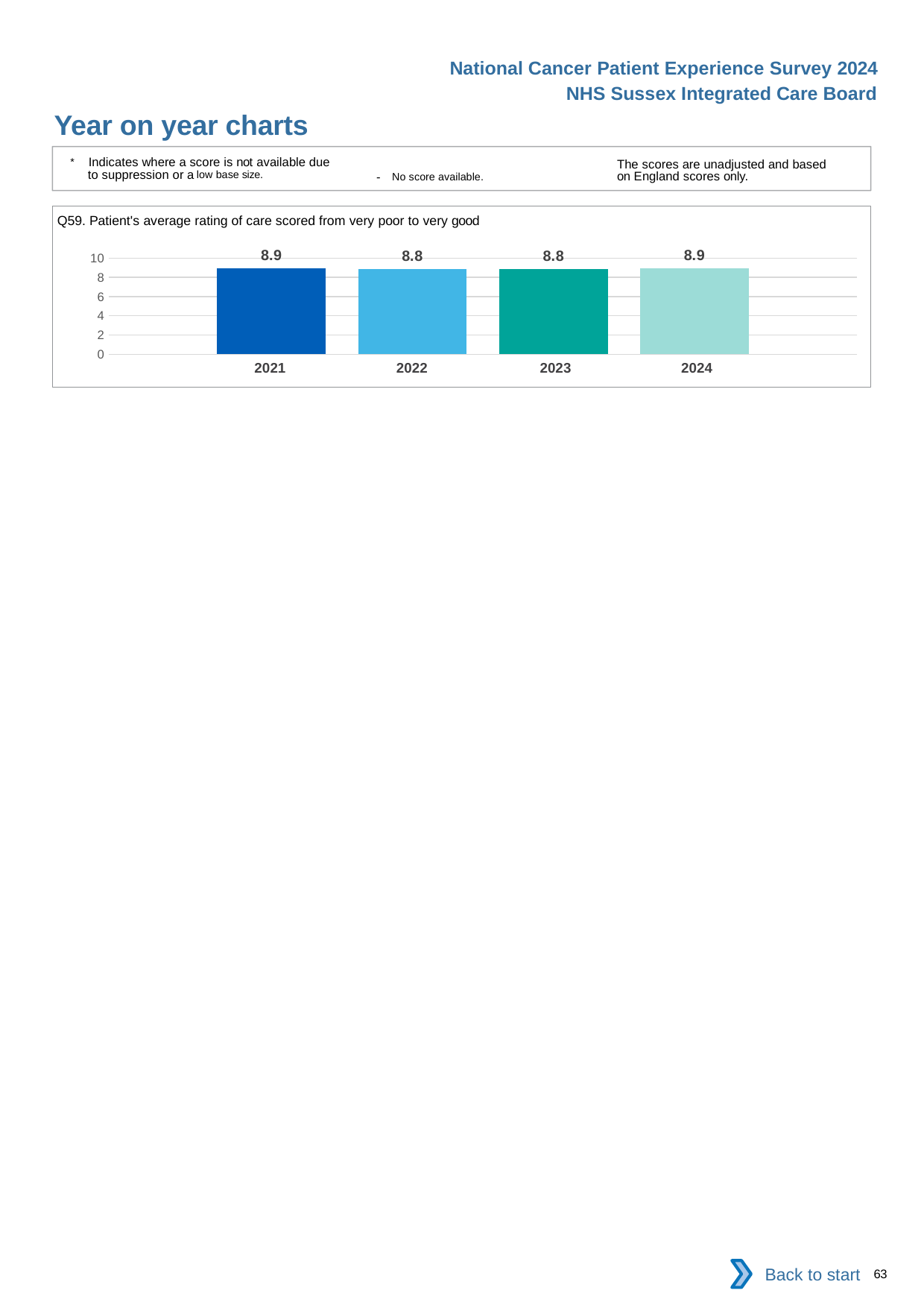
What is the value for 2021? 8.9 What is the value for 2023? 8.8 What is the highest value shown on the vertical axis? 10 What is the value for 2022? 8.8 What kind of chart is shown? bar chart What is the difference between the values for 2024 and 2023? 0.1 What is the difference between the values for 2021 and 2022? 0.1 How many years are shown on the chart? 4 Is the value for 2023 greater or less than 8? greater What is the value for 2024? 8.9 What is the title of the chart? Q59. Patient's average rating of care scored from very poor to very good